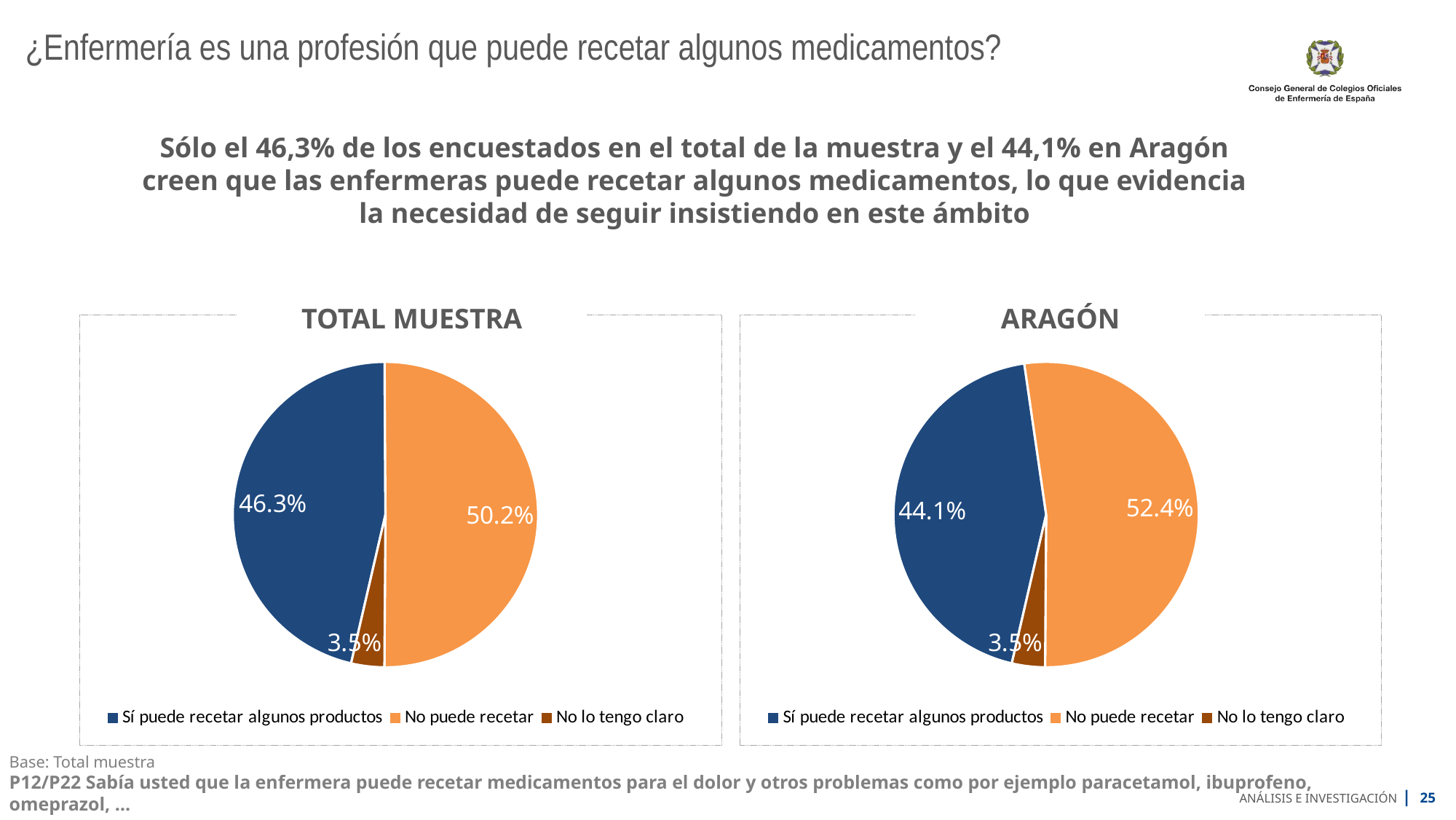
Which is larger: 'Sí puede recetar algunos productos' in the TOTAL MUESTRA chart or in the ARAGÓN chart? TOTAL MUESTRA In the ARAGÓN chart, what is the value for 'Sí puede recetar algunos productos'? 44.1% In the ARAGÓN chart, which category has the smallest slice? No lo tengo claro How many categories does the TOTAL MUESTRA chart show? 3 In the TOTAL MUESTRA chart, what is the value for 'Sí puede recetar algunos productos'? 46.3% In the ARAGÓN chart, what is the value for 'No lo tengo claro'? 3.5% In the TOTAL MUESTRA chart, what is the value for 'No puede recetar'? 50.2% In the ARAGÓN chart, what is the value for 'No puede recetar'? 52.4% In the ARAGÓN chart, what is the difference between 'No puede recetar' and 'Sí puede recetar algunos productos'? 8.3% In the TOTAL MUESTRA chart, which category has the largest slice? No puede recetar In the TOTAL MUESTRA chart, what colour is the 'No lo tengo claro' slice? Dark brown What kind of chart is the ARAGÓN chart? Pie chart